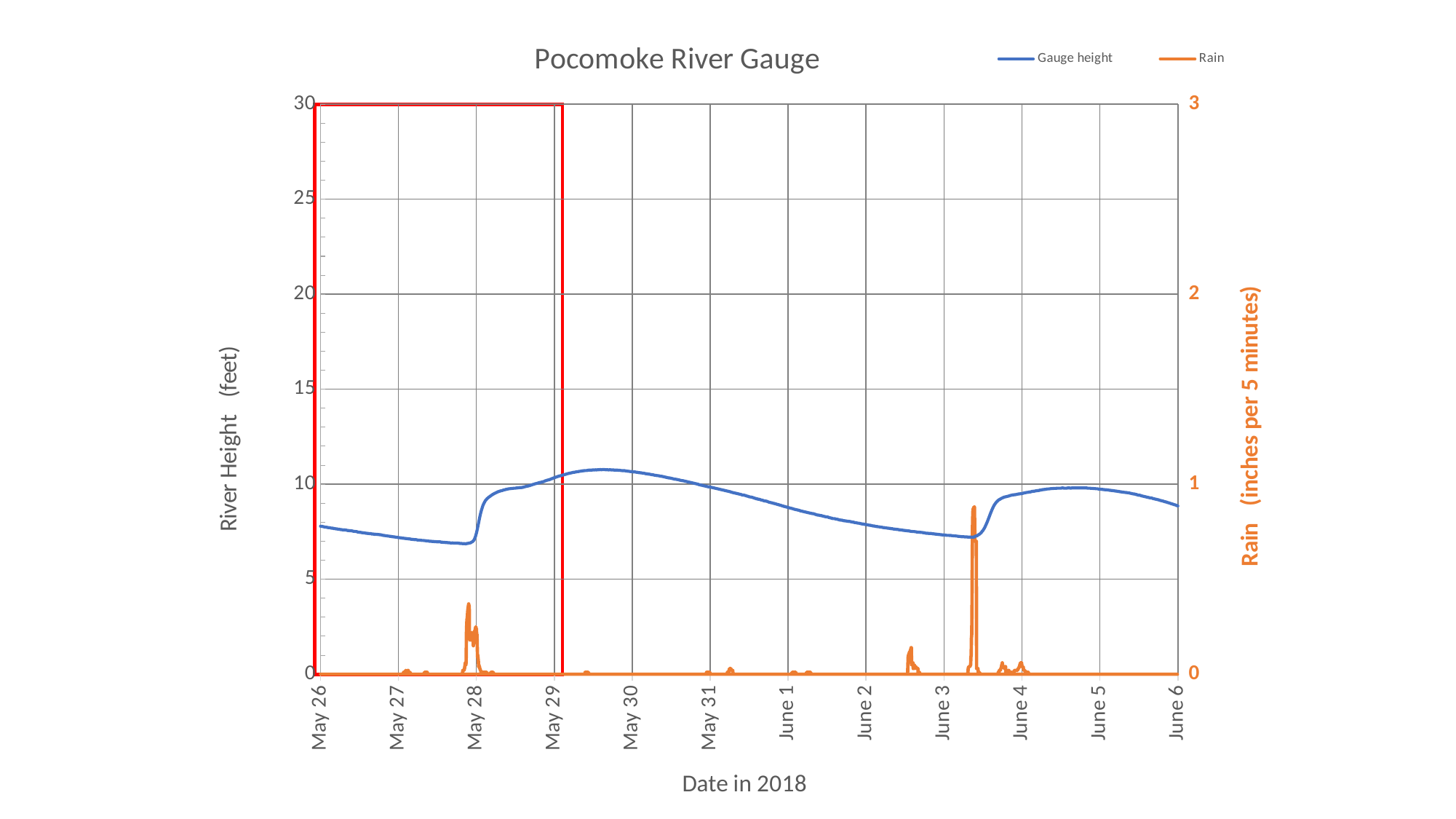
Is the highest rain value, near June 3, greater or less than 1 inch per 5 minutes? less What is the label of the right-hand vertical axis? Rain (inches per 5 minutes) How many date labels are shown along the x axis? 12 What kind of chart is shown on the slide? line chart Is the gauge height on May 30 greater or less than 10 feet? greater How many series does the legend list? 2 Is the gauge height larger on May 30 or on June 2? May 30 Does the gauge height rise or fall between May 26 and May 27? fall Is the gauge height on May 26 greater or less than 10 feet? less What is the title of the chart? Pocomoke River Gauge Does the gauge height rise or fall between June 5 and June 6? fall